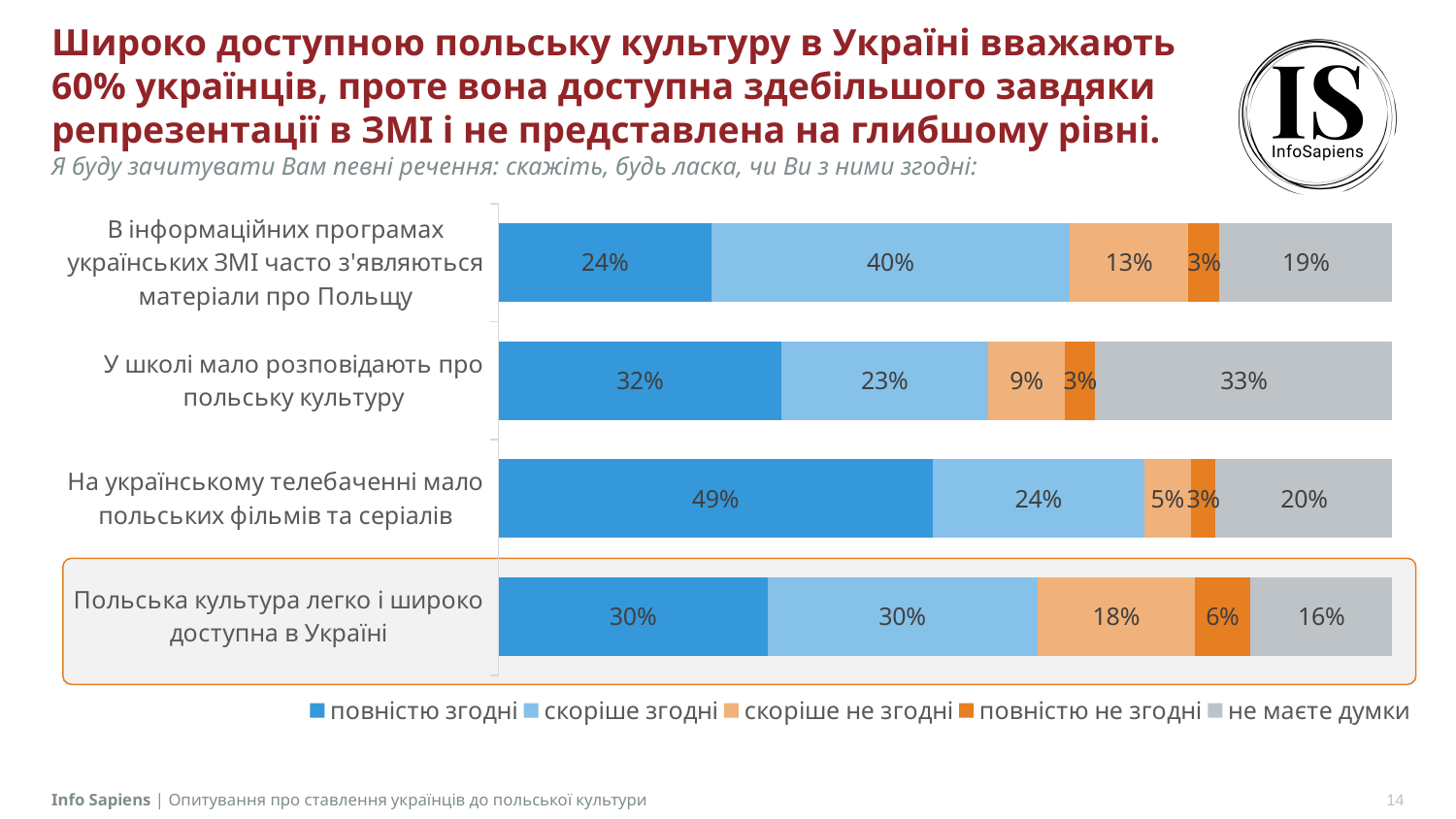
Which legend entry is shown in dark orange? повністю не згодні What is the difference between the "скоріше згодні" values for "В інформаційних програмах українських ЗМІ часто з'являються матеріали про Польщу" and "У школі мало розповідають про польську культуру"? 17% What is the combined share of "повністю згодні" and "скоріше згодні" for the statement "Польська культура легко і широко доступна в Україні"? 60% Which statement has the lowest "не маєте думки" share? Польська культура легко і широко доступна в Україні What is the "не маєте думки" value for the statement "У школі мало розповідають про польську культуру"? 33% How many series does the legend list? 5 What is the "скоріше не згодні" value for the statement "Польська культура легко і широко доступна в Україні"? 18% Which is larger: the "повністю не згодні" share for "Польська культура легко і широко доступна в Україні" or for "У школі мало розповідають про польську культуру"? Польська культура легко і широко доступна в Україні How many statements (categories) are plotted in the chart? 4 What kind of chart is shown on the slide? Stacked bar chart What share of respondents answered "повністю згодні" to the statement "На українському телебаченні мало польських фільмів та серіалів"? 49% Which statement has the highest "повністю згодні" share? На українському телебаченні мало польських фільмів та серіалів